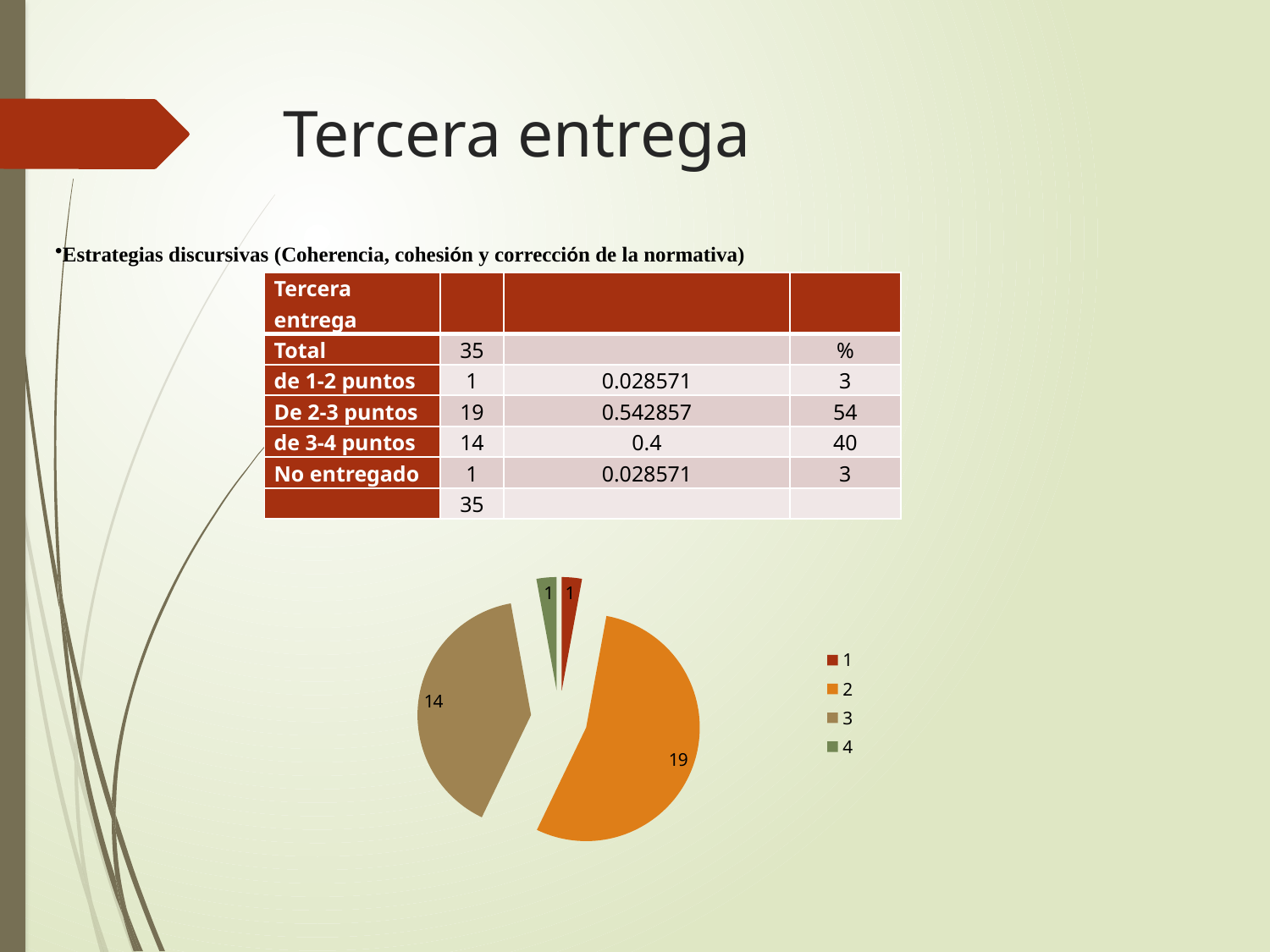
How many slices does the pie chart have? 4 What is the value of slice 2 in the pie chart? 19 What share of the pie chart does slice 3 represent? 40% Which is larger in the pie chart, slice 2 or slice 3? slice 2 What is the value of slice 4 in the pie chart? 1 What is the value of slice 1 in the pie chart? 1 What kind of chart is shown on the slide? pie chart How many entries does the legend of the pie chart list? 4 Which slice of the pie chart is the largest? 2 What is the total of all the slice values in the pie chart? 35 What is the difference between the values of slice 2 and slice 3 in the pie chart? 5 What is the value of slice 3 in the pie chart? 14